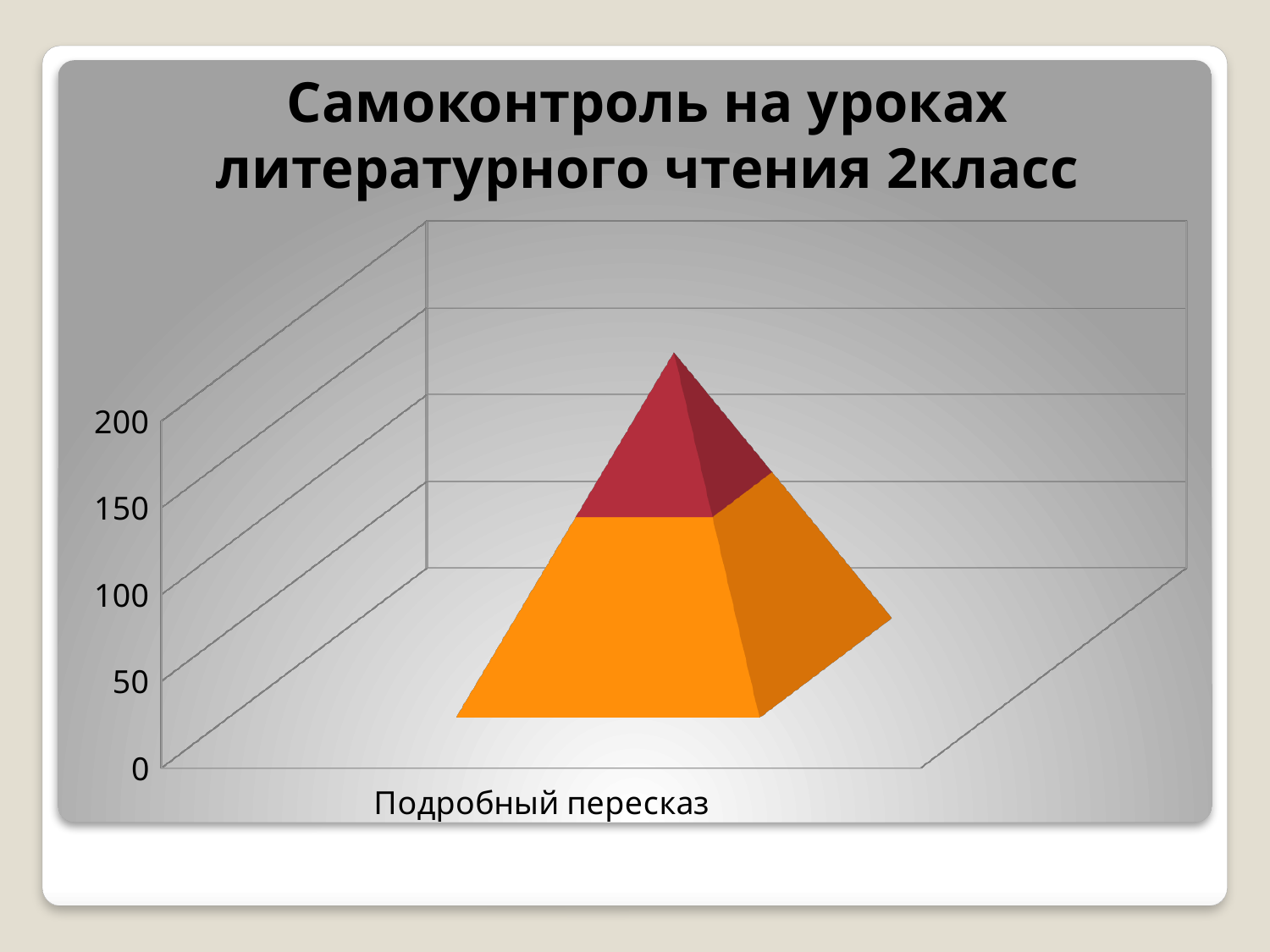
What kind of chart is shown on the slide? bar chart (3D pyramid-shaped stacked bar) What is the interval between the tick marks on the vertical axis? 50 What is the title of the chart? Самоконтроль на уроках литературного чтения 2класс What is the highest value shown on the vertical axis? 200 How many categories are shown on the x axis of the chart? 1 How many differently coloured segments make up the pyramid bar? 2 What is the label of the category shown on the x axis? Подробный пересказ